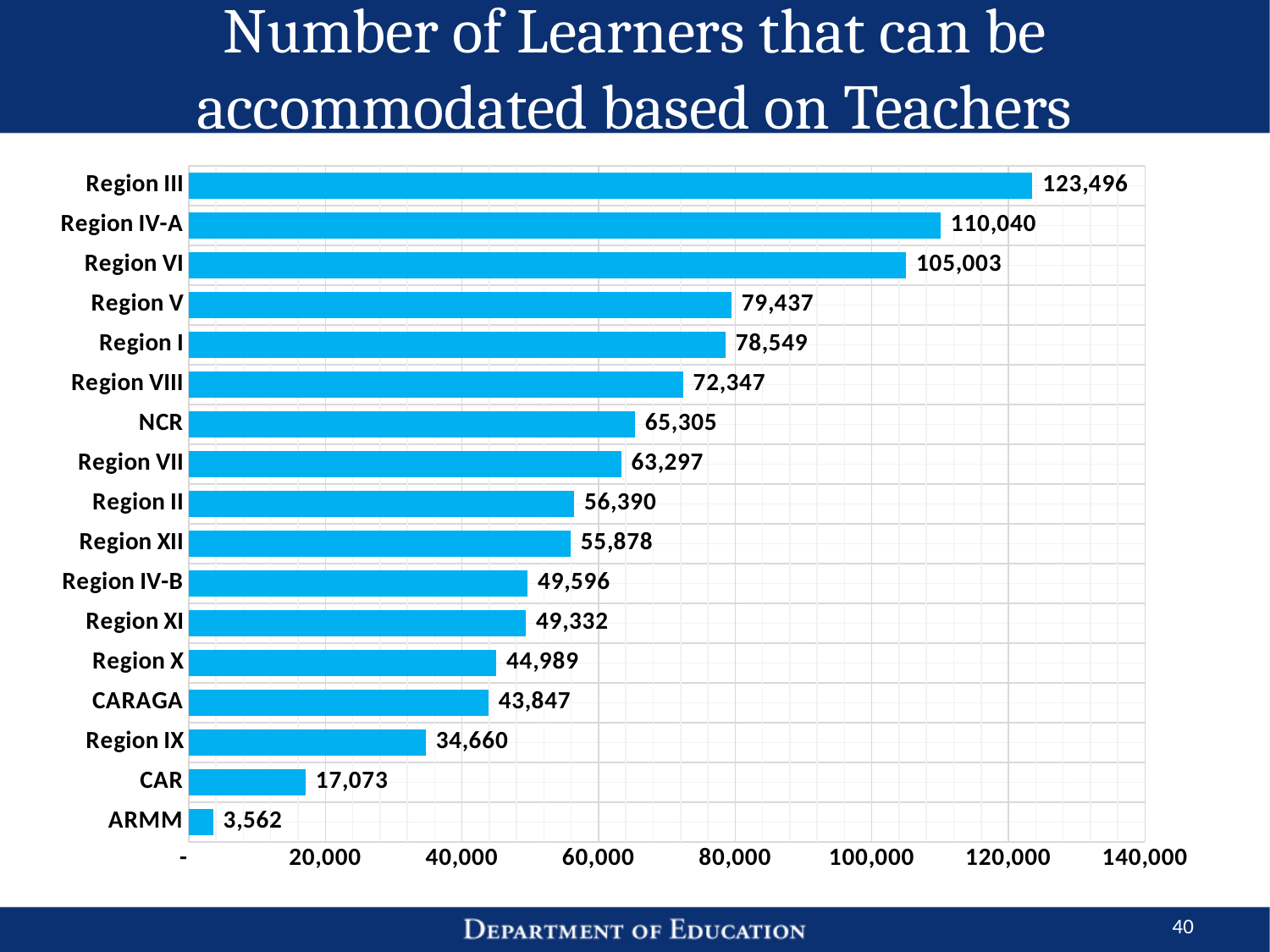
Which region has the lowest number of learners that can be accommodated? ARMM How many regions are shown in the chart? 17 What value is shown for NCR? 65,305 What is the difference between the values for Region III and Region IV-A? 13,456 What kind of chart is shown on the slide? bar chart What is the number of learners that can be accommodated in Region VI? 105,003 What is the difference between the values for CAR and ARMM? 13,511 Is the value for Region II greater or less than 60,000? less What is the title of the chart? Number of Learners that can be accommodated based on Teachers Which is larger, the value for Region VIII or the value for Region IX? Region VIII Which region has the highest number of learners that can be accommodated? Region III What is the value for CARAGA? 43,847